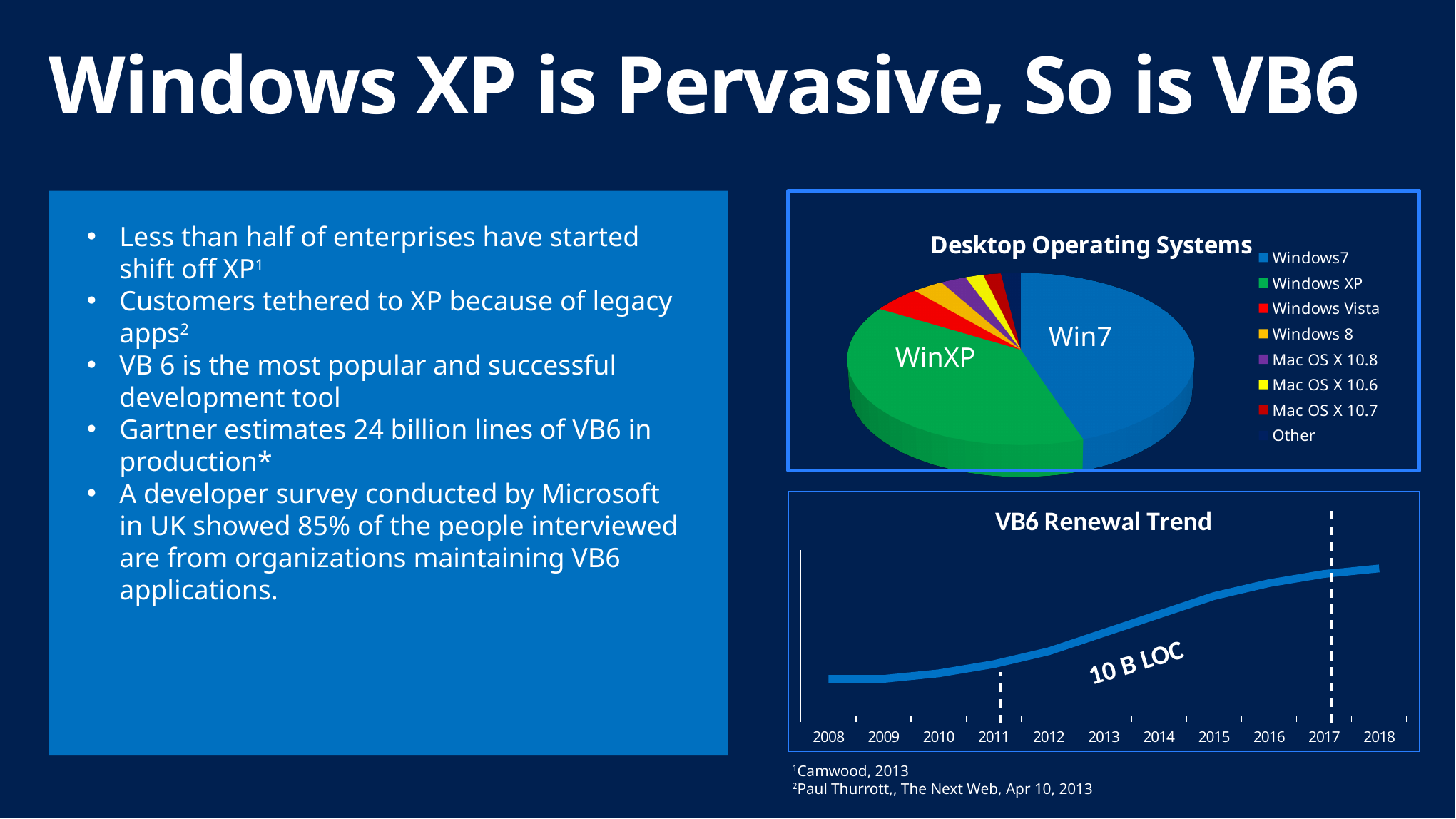
In the "Desktop Operating Systems" chart, what colour is the Windows XP slice? green What kind of chart is the "Desktop Operating Systems" chart? pie chart In the "Desktop Operating Systems" chart, which operating system has the largest slice? Windows7 What is the first year shown on the x axis of the "VB6 Renewal Trend" chart? 2008 How many entries does the legend of the "Desktop Operating Systems" chart list? 8 In the "Desktop Operating Systems" chart, which slice is larger, Win7 or WinXP? Win7 What kind of chart is the "VB6 Renewal Trend" chart? line chart In the "VB6 Renewal Trend" chart, does the line rise or fall from 2008 to 2018? rise What annotation is written along the line in the "VB6 Renewal Trend" chart? 10 B LOC In the "Desktop Operating Systems" chart, which slice is larger, Windows XP or Windows Vista? Windows XP How many years are labelled on the x axis of the "VB6 Renewal Trend" chart? 11 What is the last year shown on the x axis of the "VB6 Renewal Trend" chart? 2018